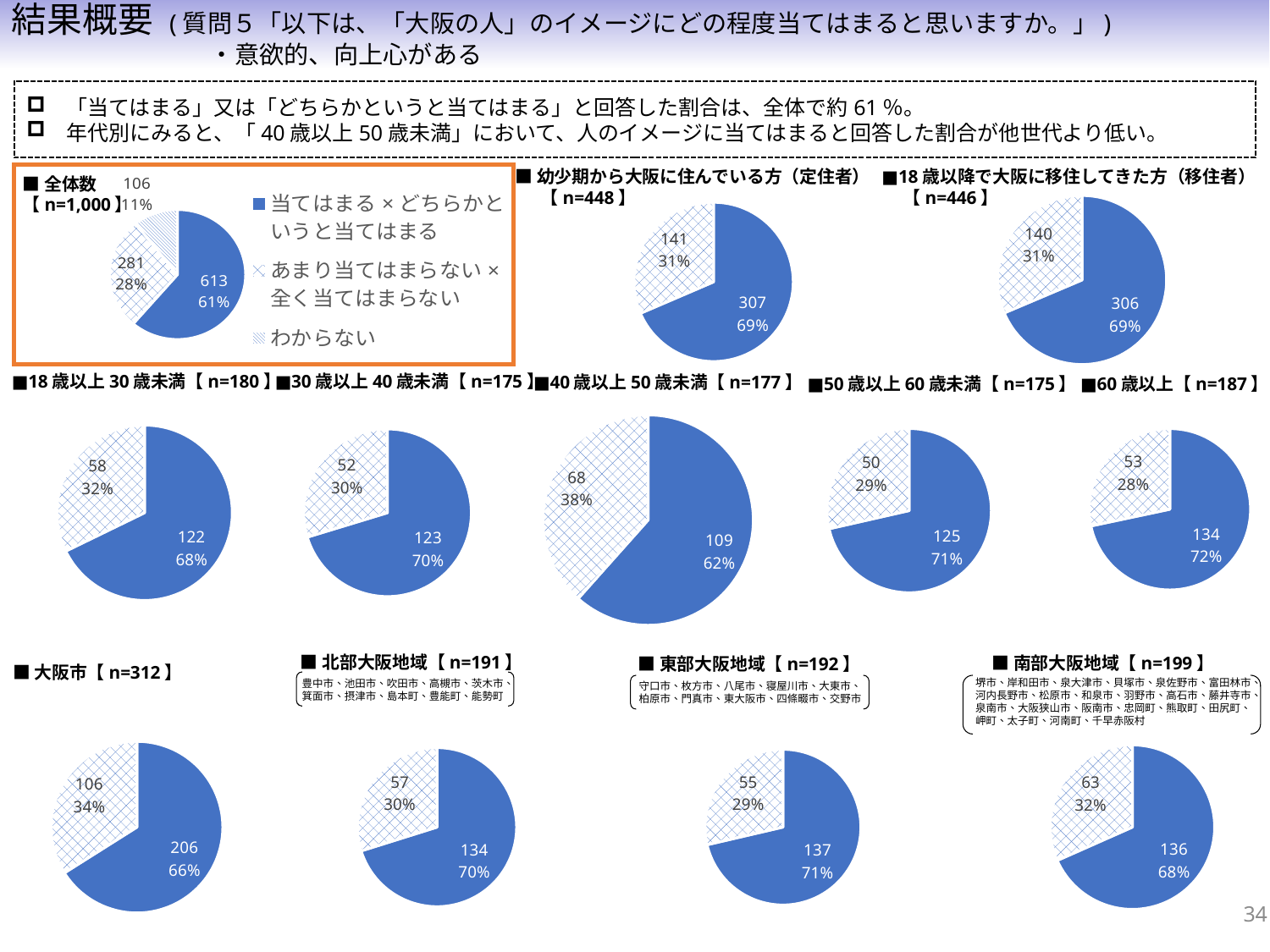
Which has a larger 当てはまる×どちらかというと当てはまる percentage: the 大阪市【n=312】 chart or the 東部大阪地域【n=192】 chart? 東部大阪地域 In the 全体数【n=1,000】 pie chart, what percentage is shown for 当てはまる×どちらかというと当てはまる? 61% What is the difference in count between the two slices of the 18歳以降で大阪に移住してきた方（移住者）【n=446】 pie chart? 166 In the 幼少期から大阪に住んでいる方（定住者）【n=448】 pie chart, how many respondents are in the 当てはまる×どちらかというと当てはまる slice? 307 In the 全体数【n=1,000】 pie chart, how many respondents answered わからない? 106 What type of chart is used for the 40歳以上50歳未満【n=177】 data? Pie chart How many pie charts are shown on the slide in total? 12 Among the five age-group pie charts, which group has the highest percentage for 当てはまる×どちらかというと当てはまる? 60歳以上 In the 40歳以上50歳未満【n=177】 pie chart, what percentage is shown for the あまり当てはまらない×全く当てはまらない slice? 38% Among the five age-group pie charts, which group has the lowest percentage for 当てはまる×どちらかというと当てはまる? 40歳以上50歳未満 How many entries does the legend next to the 全体数 pie chart list? 3 In the 南部大阪地域【n=199】 pie chart, what count is shown for the あまり当てはまらない×全く当てはまらない slice? 63